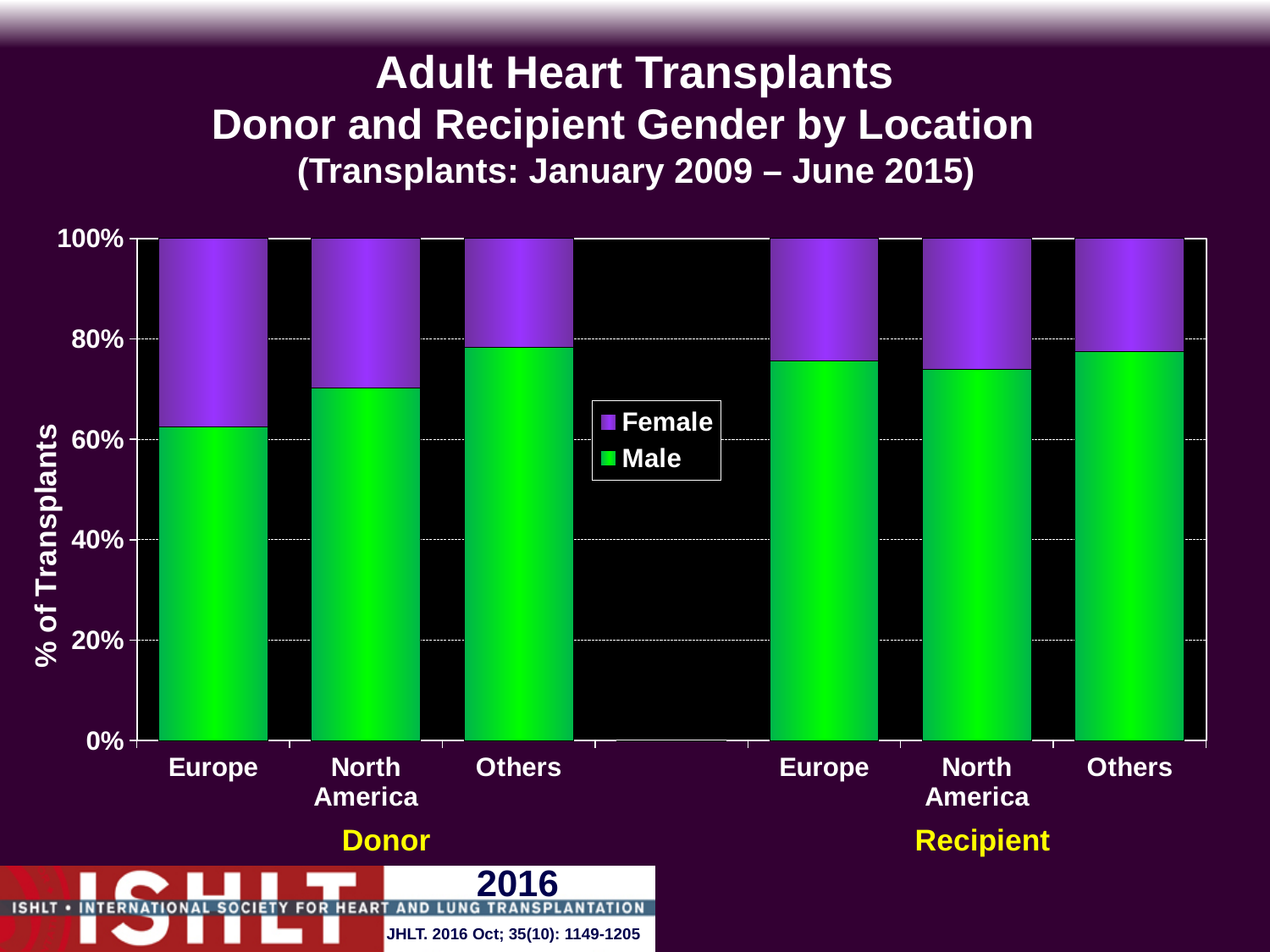
Is the Male share for Donor Europe greater or less than 80%? less How many series does the legend list? 2 Is the Male share for Recipient Europe greater or less than 80%? less Which has the larger Female share: Donor Europe or Donor Others? Donor Europe Is the Male share for Donor Others greater or less than 60%? greater How many bars are plotted in the chart? 6 Among the Donor groups, which location has the lowest Male share? Europe What kind of chart is shown on the slide? stacked bar chart What is the label of the y axis? % of Transplants What are the two series named in the legend? Female and Male Among the Donor groups, which location has the highest Male share? Others